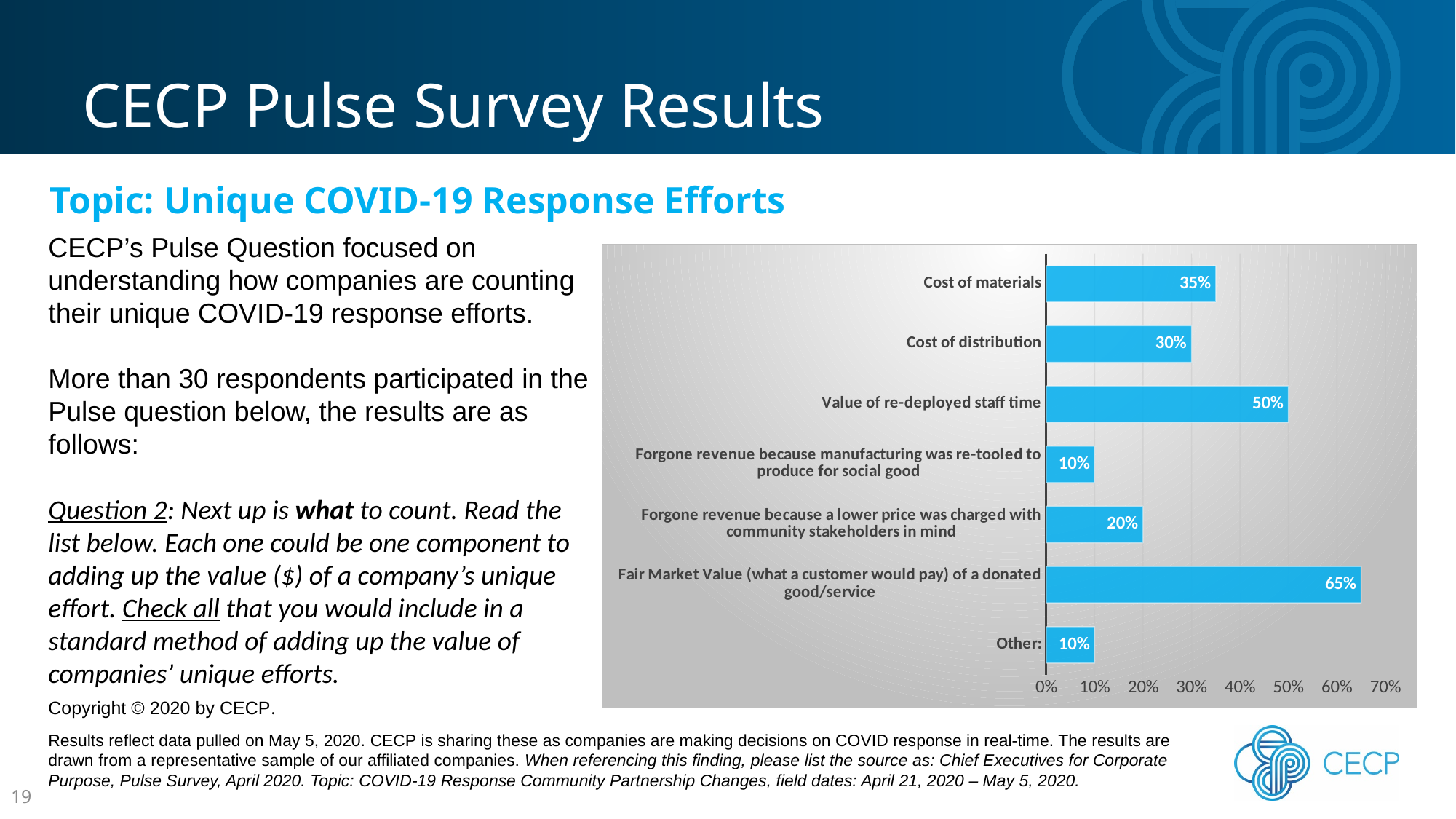
What is the value for Cost of materials? 35% What is the highest value shown on the x axis of the chart? 70% What is the difference between the values for Cost of materials and Cost of distribution? 5% What is the value for Forgone revenue because a lower price was charged with community stakeholders in mind? 20% Is the value for Cost of materials greater or less than 40%? less What is the difference between the values for Fair Market Value of a donated good/service and Value of re-deployed staff time? 15% How many categories are shown in the chart? 7 Which category has the highest value? Fair Market Value (what a customer would pay) of a donated good/service Which is larger, the value for Cost of distribution or the value for Value of re-deployed staff time? Value of re-deployed staff time What is the value for Value of re-deployed staff time? 50% What is the value for Fair Market Value (what a customer would pay) of a donated good/service? 65% What kind of chart is shown on the slide? bar chart